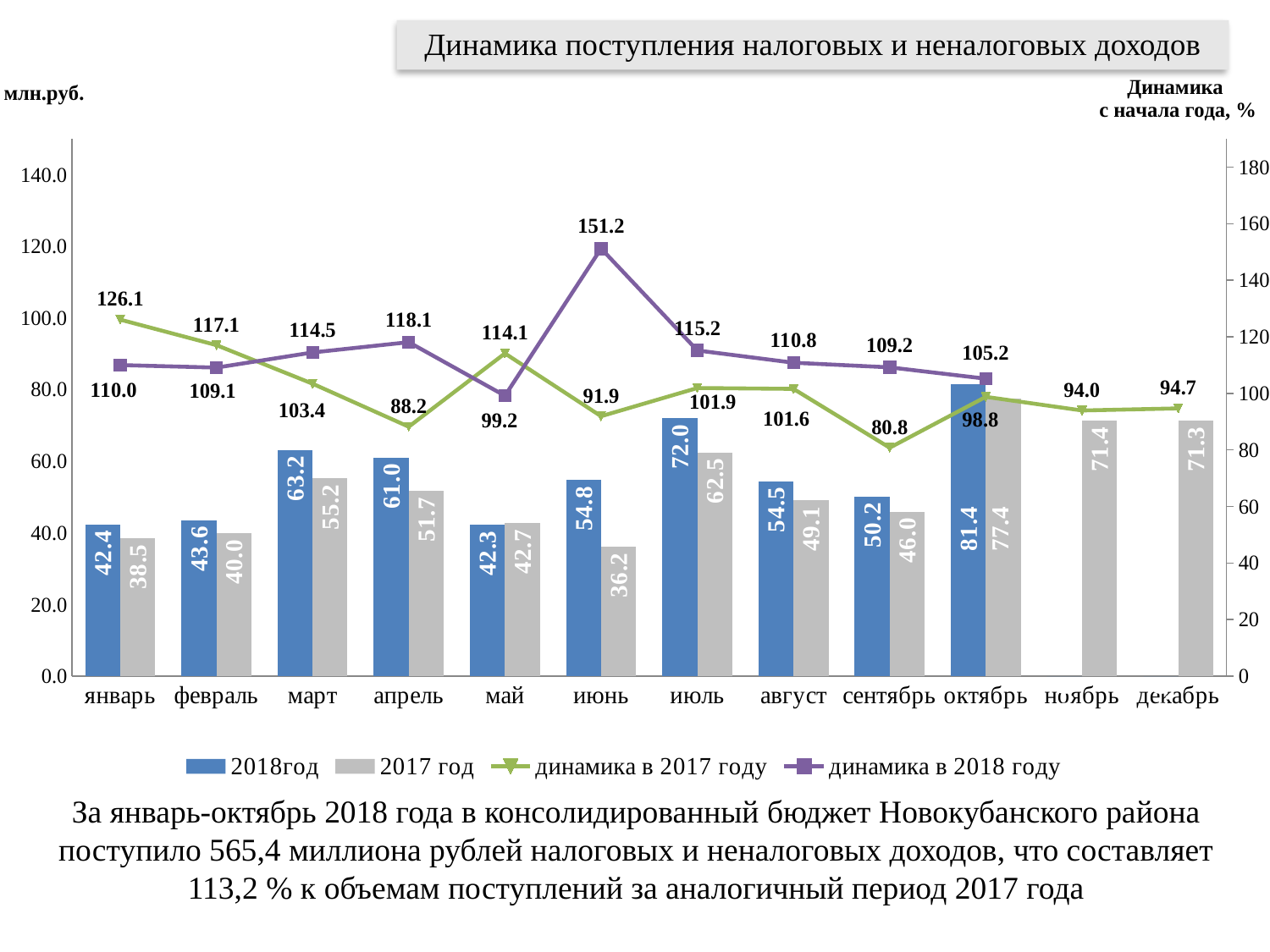
For май, which is larger: the 2018год value or the 2017 год value? 2017 год What is the title of the chart? Динамика поступления налоговых и неналоговых доходов What is the value of the 2018год series for октябрь? 81.4 What is the value of the 2017 год series for июнь? 36.2 How many series does the legend list? 4 Which month has the highest value in the 2018год series? октябрь What is the value of the динамика в 2018 году series for июнь? 151.2 Which month has the lowest value in the 2017 год series? июнь How many months are shown on the x axis? 12 What is the difference between the 2018год and 2017 год values for июль? 9.5 Which month has the lowest value in the динамика в 2017 году series? сентябрь What is the difference between the 2018год and 2017 год values for октябрь? 4.0